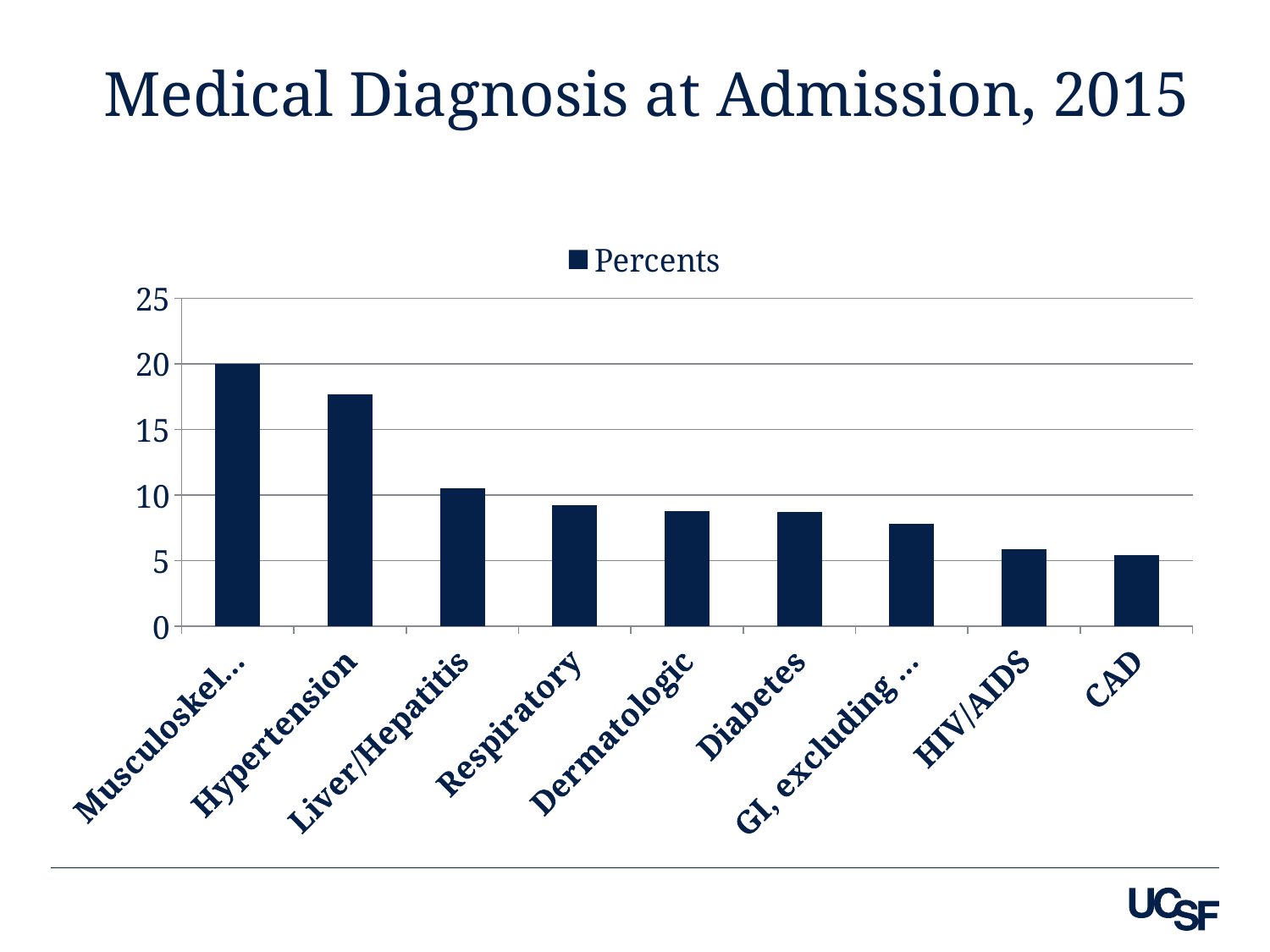
How many categories are plotted in the chart? 9 Which is larger, the value for Respiratory or the value for CAD? Respiratory What is the title of the chart? Medical Diagnosis at Admission, 2015 How many series does the legend list? 1 What is the name of the series shown in the legend? Percents Is the value for HIV/AIDS greater or less than 5? greater Do the values rise or fall from left to right along the x axis? fall Is the value for Respiratory greater or less than 10? less Which category has the lowest value? CAD Is the value for Hypertension greater or less than 15? greater What kind of chart is shown on the slide? bar chart Which is larger, the value for Hypertension or the value for Liver/Hepatitis? Hypertension